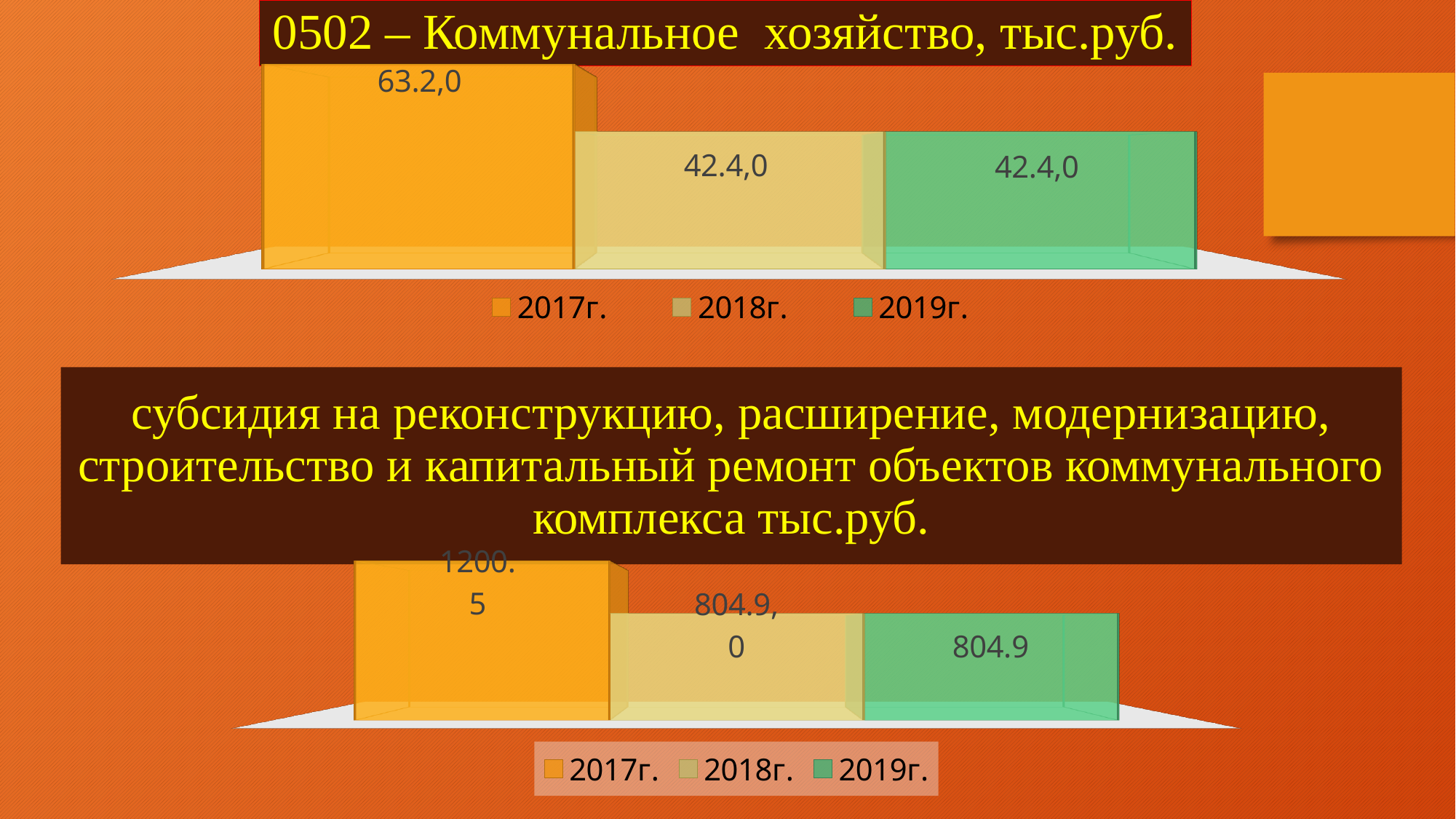
In the top chart '0502 – Коммунальное хозяйство, тыс.руб.', what is the value for 2017г.? 63.2,0 In the bottom chart about the subsidy (субсидия на реконструкцию...), what is the value for 2019г.? 804.9 In the top chart '0502 – Коммунальное хозяйство, тыс.руб.', what is the value for 2018г.? 42.4,0 In the bottom chart about the subsidy (субсидия на реконструкцию...), which is larger: the value for 2017г. or the value for 2019г.? 2017г. In the bottom chart about the subsidy (субсидия на реконструкцию...), what is the difference between the values for 2017г. and 2019г.? 395.6 In the bottom chart about the subsidy (субсидия на реконструкцию...), which year has the highest value? 2017г. In the top chart '0502 – Коммунальное хозяйство, тыс.руб.', how many series does the legend list? 3 In the bottom chart about the subsidy (субсидия на реконструкцию...), what is the value for 2017г.? 1200.5 In the top chart '0502 – Коммунальное хозяйство, тыс.руб.', which year has the highest value? 2017г. In the top chart '0502 – Коммунальное хозяйство, тыс.руб.', which colour represents 2019г. in the legend? green What kind of chart is the top chart '0502 – Коммунальное хозяйство, тыс.руб.'? bar chart In the bottom chart about the subsidy (субсидия на реконструкцию...), how many bars are plotted? 3